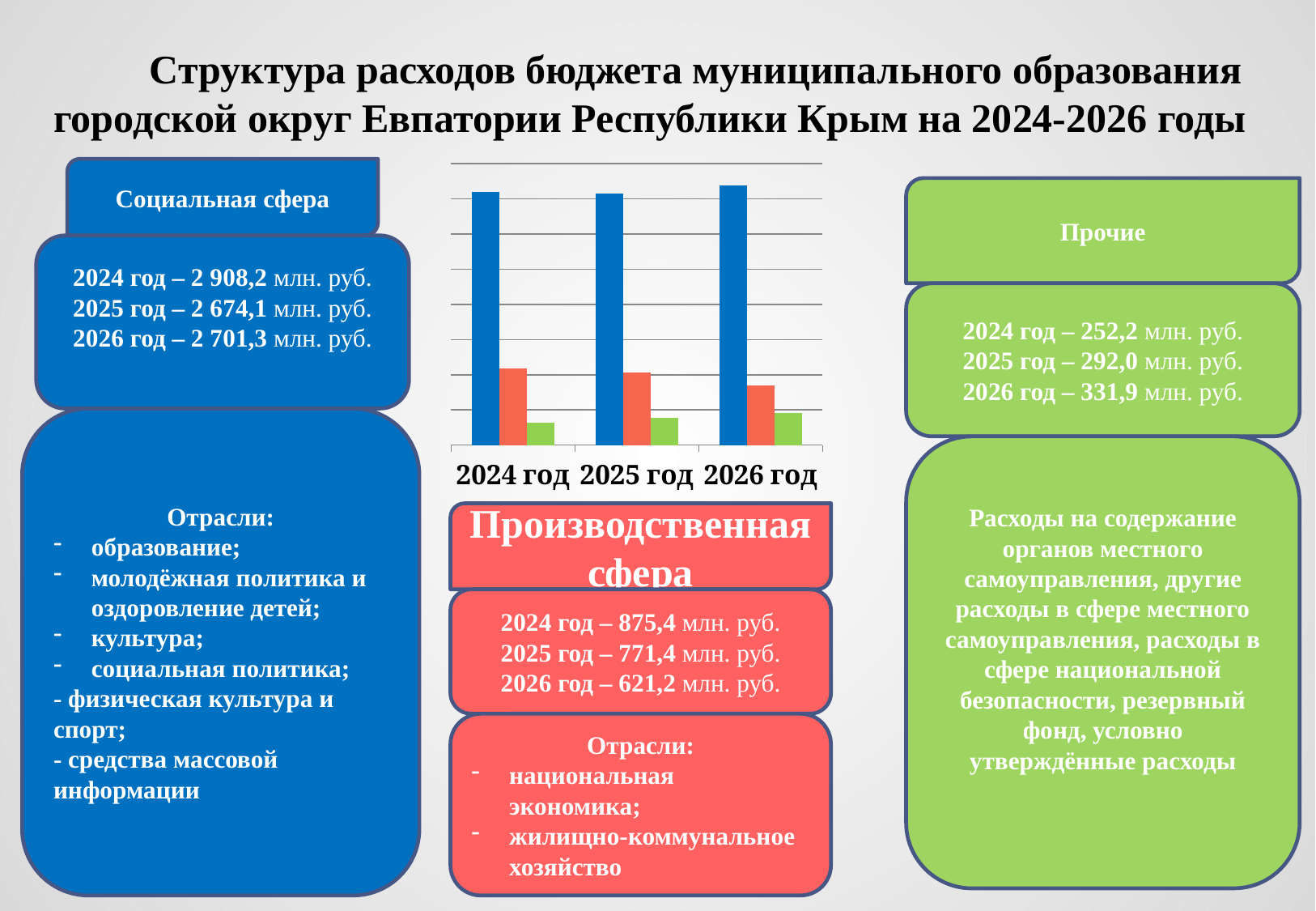
According to the slide, what is the value for Прочие in 2026 год? 331,9 млн. руб. What kind of chart is shown on the slide? bar chart In the chart, is the orange bar for 2024 год taller or shorter than the green bar for 2024 год? taller How many categories are shown on the x axis of the chart? 3 According to the slide, what is the value for Социальная сфера in 2024 год? 2 908,2 млн. руб. Which year's label appears first on the x axis of the chart? 2024 год Which coloured bar is the tallest in every year group of the chart? blue Which coloured bar is the shortest in every year group of the chart? green How many bars are plotted for each year in the chart? 3 Do the orange bars in the chart rise or fall from 2024 год to 2026 год? fall In the chart, is the blue bar for 2026 год taller or shorter than the blue bar for 2025 год? taller Do the green bars in the chart rise or fall from 2024 год to 2026 год? rise